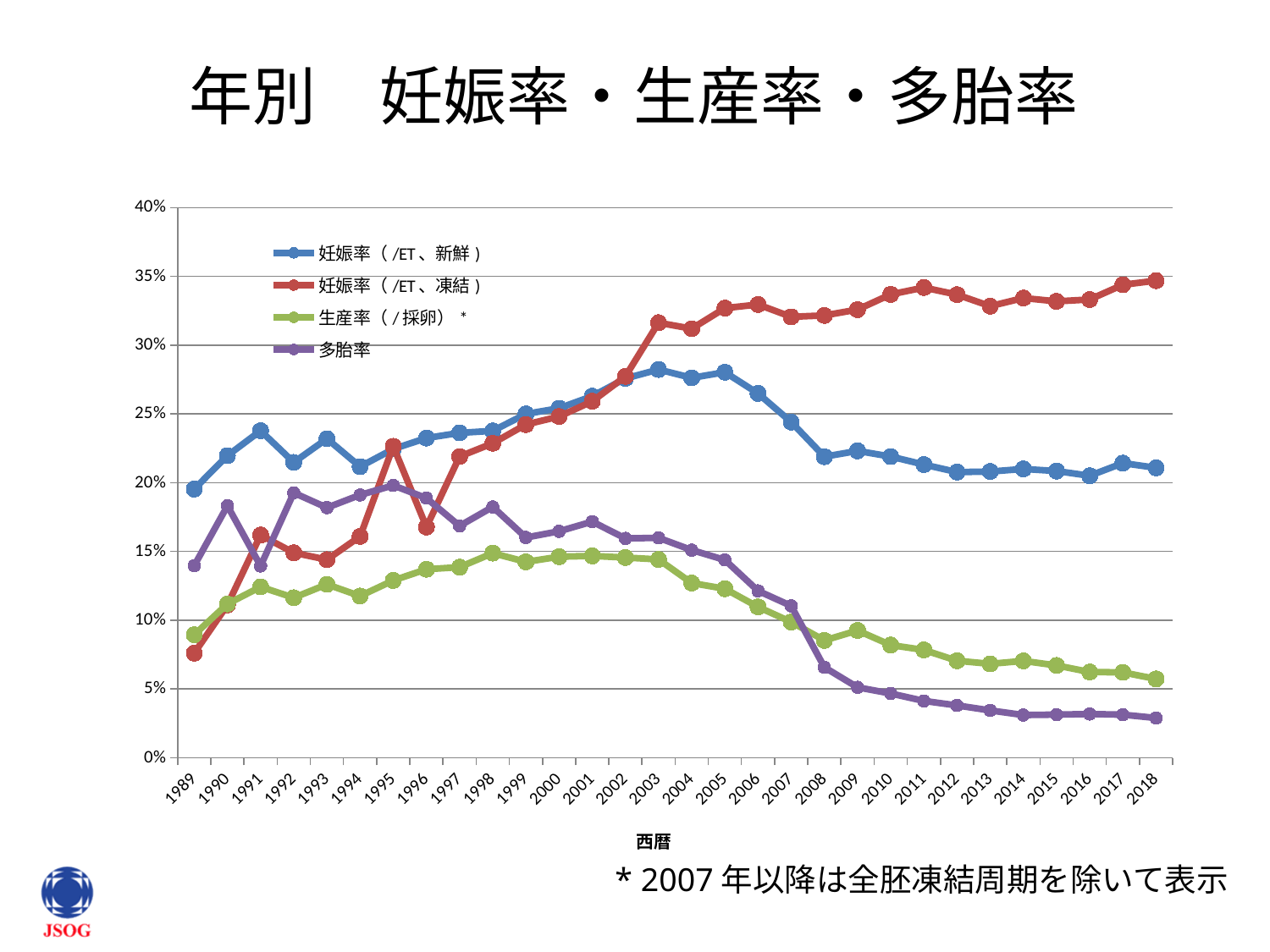
Is the value for 妊娠率（/ET、新鮮） in 2018 greater or less than 25%? less Is the value for 多胎率 in 2018 greater or less than 5%? less How many years are plotted along the x axis? 30 What kind of chart is shown on the slide? line chart Is the value for 妊娠率（/ET、凍結） in 2018 greater or less than 30%? greater In 1989, which is higher: 妊娠率（/ET、新鮮） or 妊娠率（/ET、凍結）? 妊娠率（/ET、新鮮） What is the title of the x axis? 西暦 Does 多胎率 rise or fall from 2005 to 2018? fall In 2018, which is higher: 妊娠率（/ET、新鮮） or 妊娠率（/ET、凍結）? 妊娠率（/ET、凍結） How many series does the legend list? 4 Which series has the lowest value in 2018? 多胎率